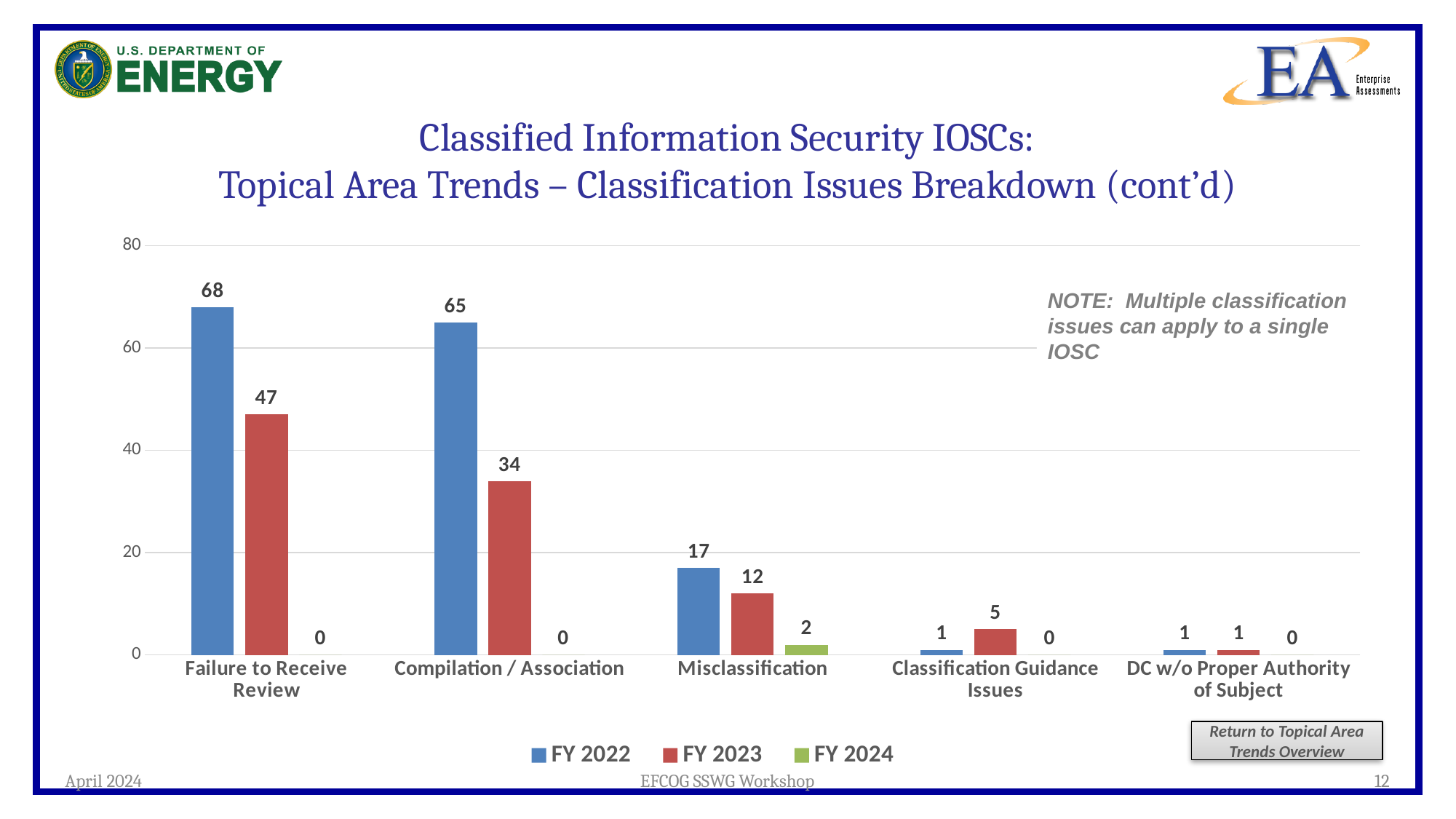
Which category has the lowest FY 2023 value? DC w/o Proper Authority of Subject What is the FY 2024 value for Misclassification? 2 Which is larger for Misclassification: the FY 2022 value or the FY 2023 value? FY 2022 What kind of chart is shown on the slide? Bar chart How many categories are shown on the x axis? 5 How many series does the legend list? 3 What is the difference between the FY 2022 and FY 2023 values for Failure to Receive Review? 21 What is the FY 2022 value for Failure to Receive Review? 68 What is the FY 2023 value for Classification Guidance Issues? 5 What is the FY 2023 value for Compilation / Association? 34 Which series is shown in green in the legend? FY 2024 Which category has the highest FY 2022 value? Failure to Receive Review